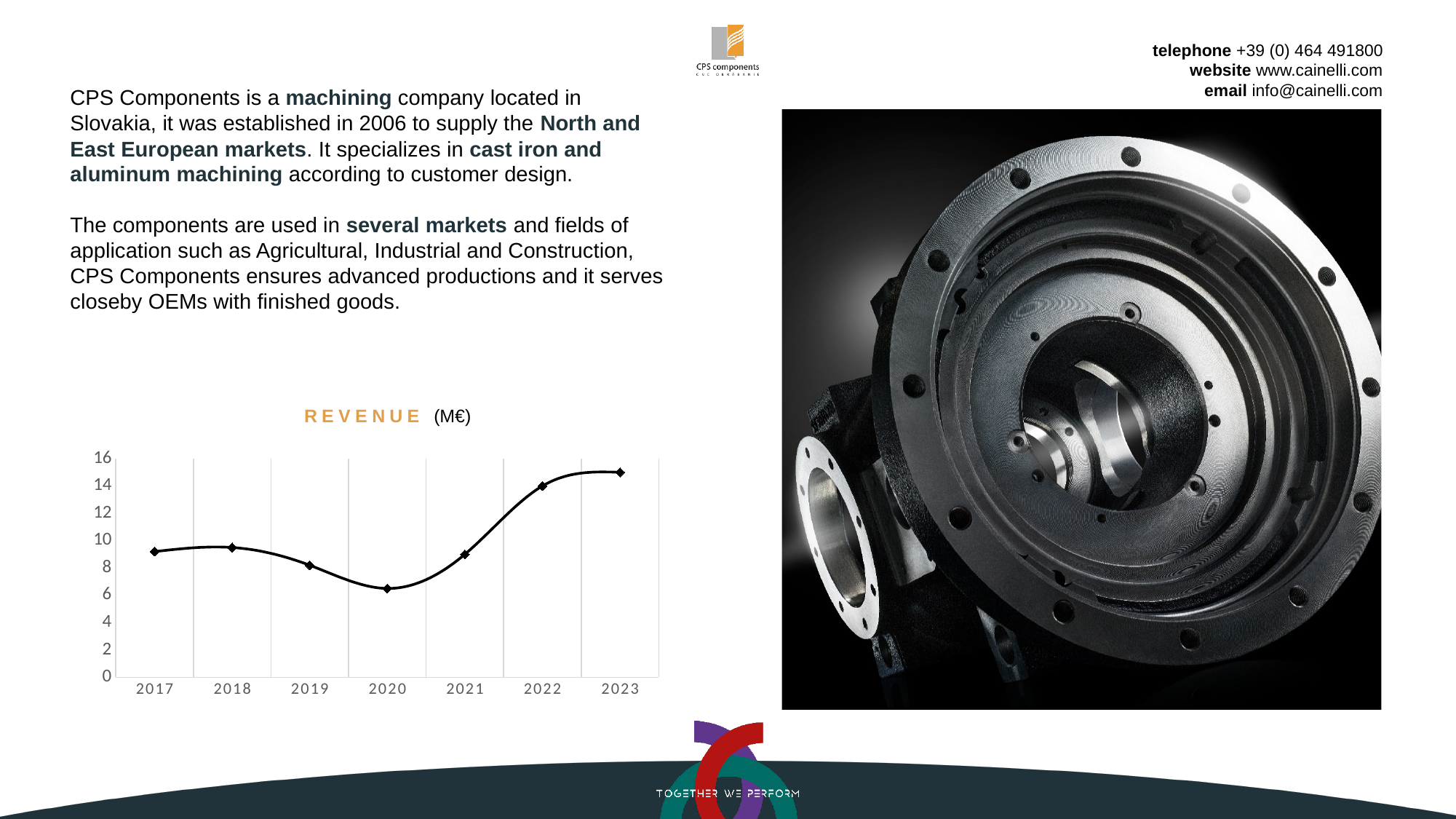
Which year has the lowest revenue on the chart? 2020 Is the revenue for 2017 greater or less than 10? less Does revenue rise or fall from 2020 to 2023? rise Is the revenue for 2022 greater or less than 12? greater What kind of chart is shown on the slide? line chart Does revenue rise or fall from 2018 to 2020? fall Is the revenue for 2020 greater or less than 8? less How many years are plotted on the revenue chart? 7 Which year has the highest revenue on the chart? 2023 Which year has the higher revenue, 2019 or 2022? 2022 In what unit is revenue shown in the chart title? M€